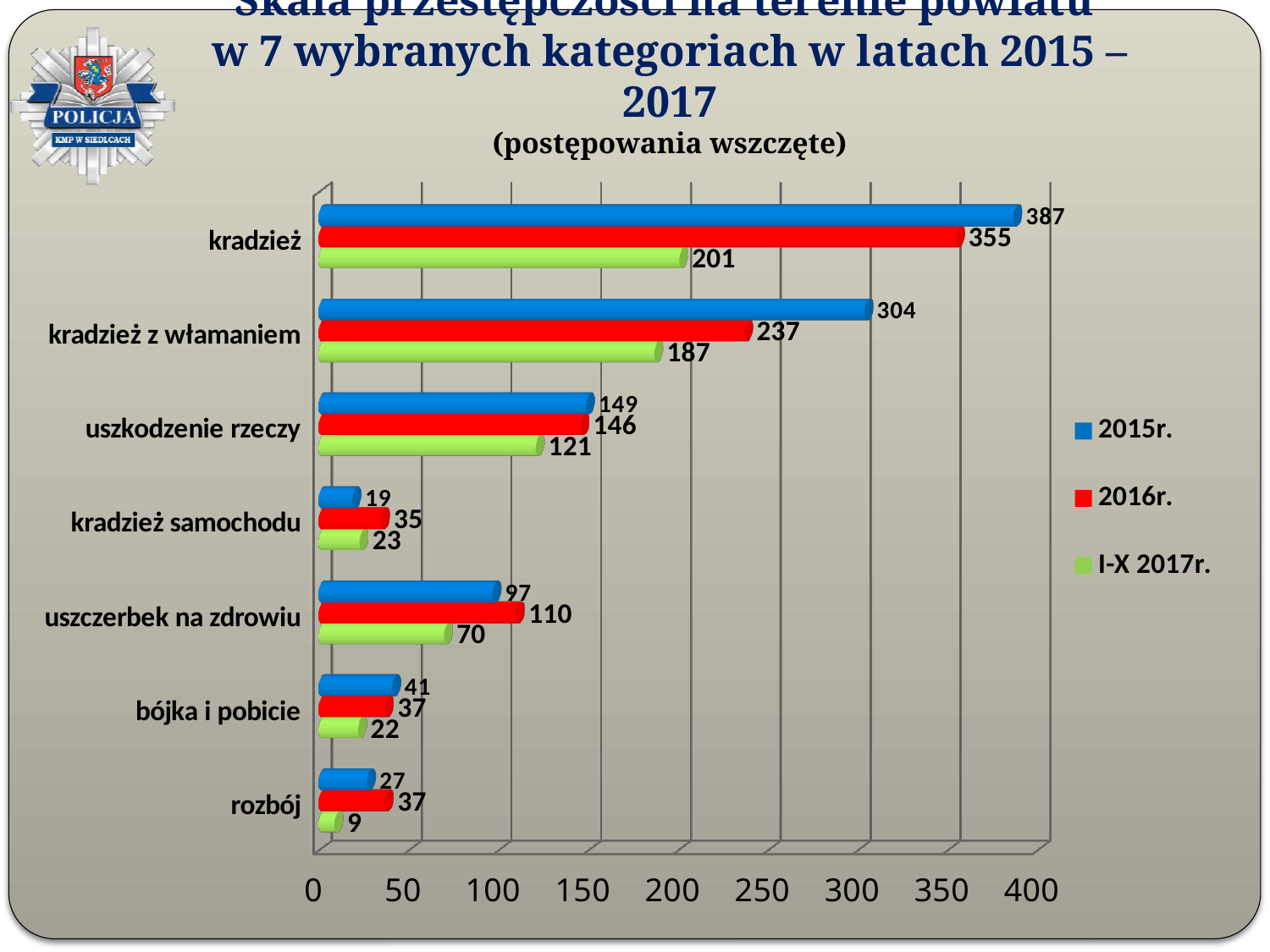
What kind of chart is shown on the slide? bar chart What is the value for rozbój in the I-X 2017r. series? 9 How many categories are shown on the chart? 7 How many series does the legend list? 3 Which category has the lowest value in the I-X 2017r. series? rozbój What is the difference between the 2016r. and I-X 2017r. values for uszkodzenie rzeczy? 25 Which colour represents the I-X 2017r. series? green Which category has the highest value in the 2015r. series? kradzież What is the value for kradzież in the 2015r. series? 387 What is the value for uszczerbek na zdrowiu in the 2016r. series? 110 Which is larger for kradzież samochodu: the 2015r. value or the 2016r. value? 2016r. What is the difference between the 2015r. and 2016r. values for kradzież z włamaniem? 67